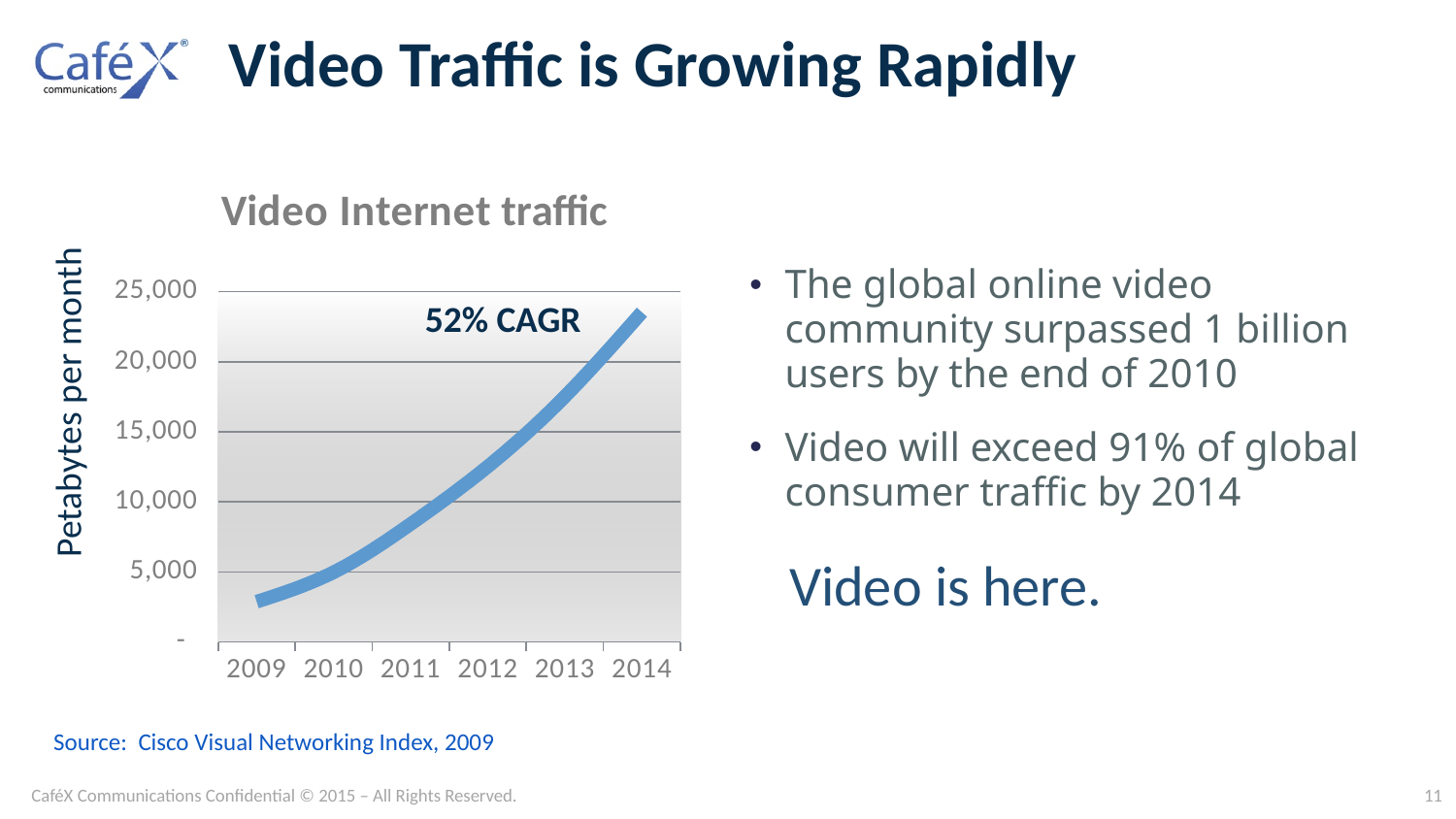
What is the label on the y-axis of the chart? Petabytes per month Which year has a larger value, 2011 or 2013? 2013 Which year has the highest video Internet traffic in the chart? 2014 What type of chart is shown on the slide? line chart What is the title of the chart? Video Internet traffic Is the value for 2012 greater or less than 10,000? greater How many years are shown on the x-axis of the chart? 6 Which year has the lowest video Internet traffic in the chart? 2009 Does video Internet traffic rise or fall from 2009 to 2014? rise Is the value for 2013 greater or less than 15,000? greater Is the value for 2009 greater or less than 5,000? less